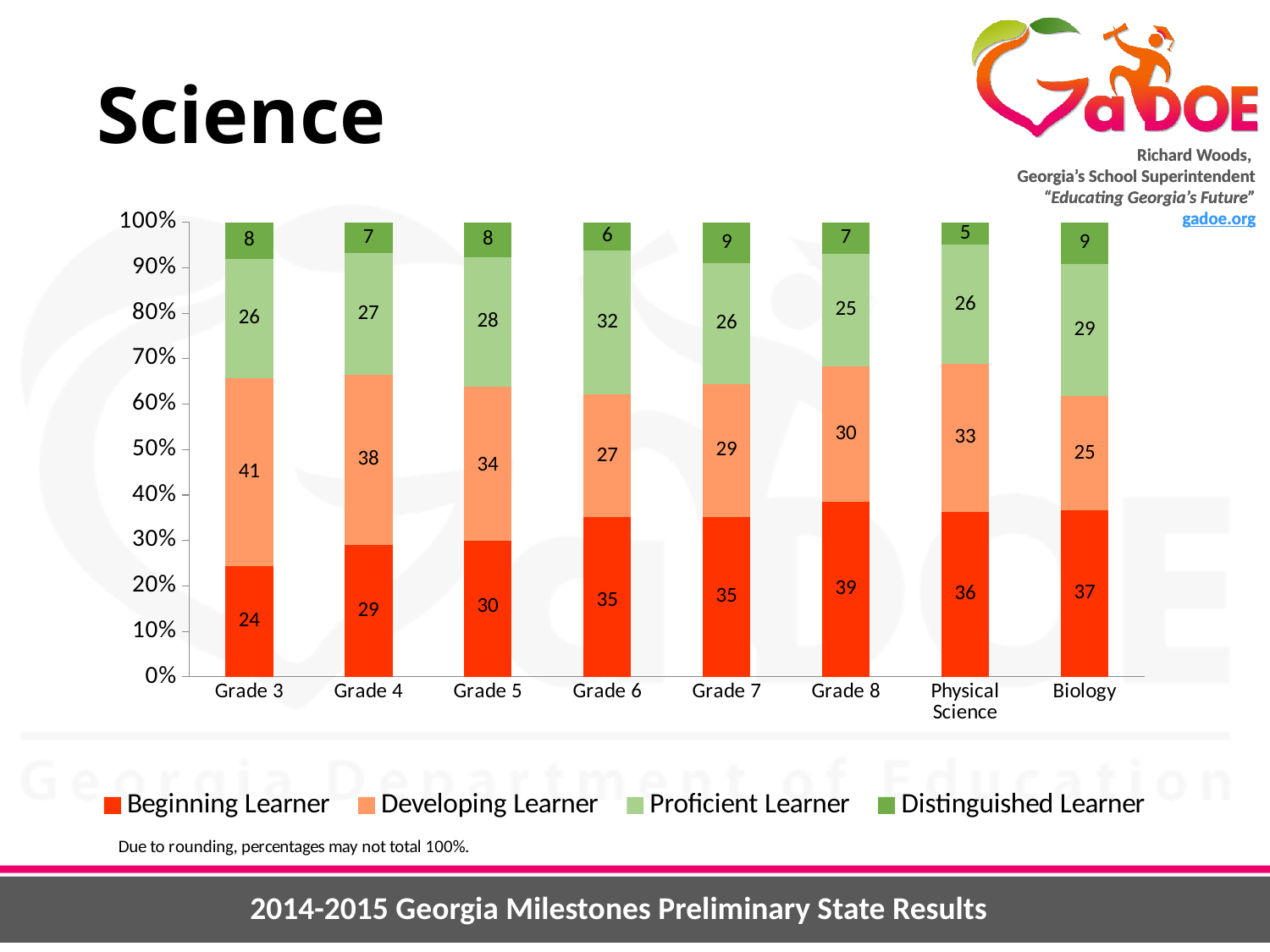
What is the Proficient Learner value for Grade 6? 32 What kind of chart is shown on the slide? Stacked bar chart Which category has the highest Developing Learner value? Grade 3 What is the difference between the Developing Learner and Beginning Learner values for Grade 3? 17 Which category has the lowest Developing Learner value? Biology Which category has the highest Beginning Learner value? Grade 8 How many categories are shown on the x axis? 8 What is the Distinguished Learner value for Physical Science? 5 What is the Developing Learner value for Biology? 25 What is the Beginning Learner value for Grade 3? 24 How many series does the legend list? 4 Which is larger, the Beginning Learner value for Grade 8 or for Grade 4? Grade 8